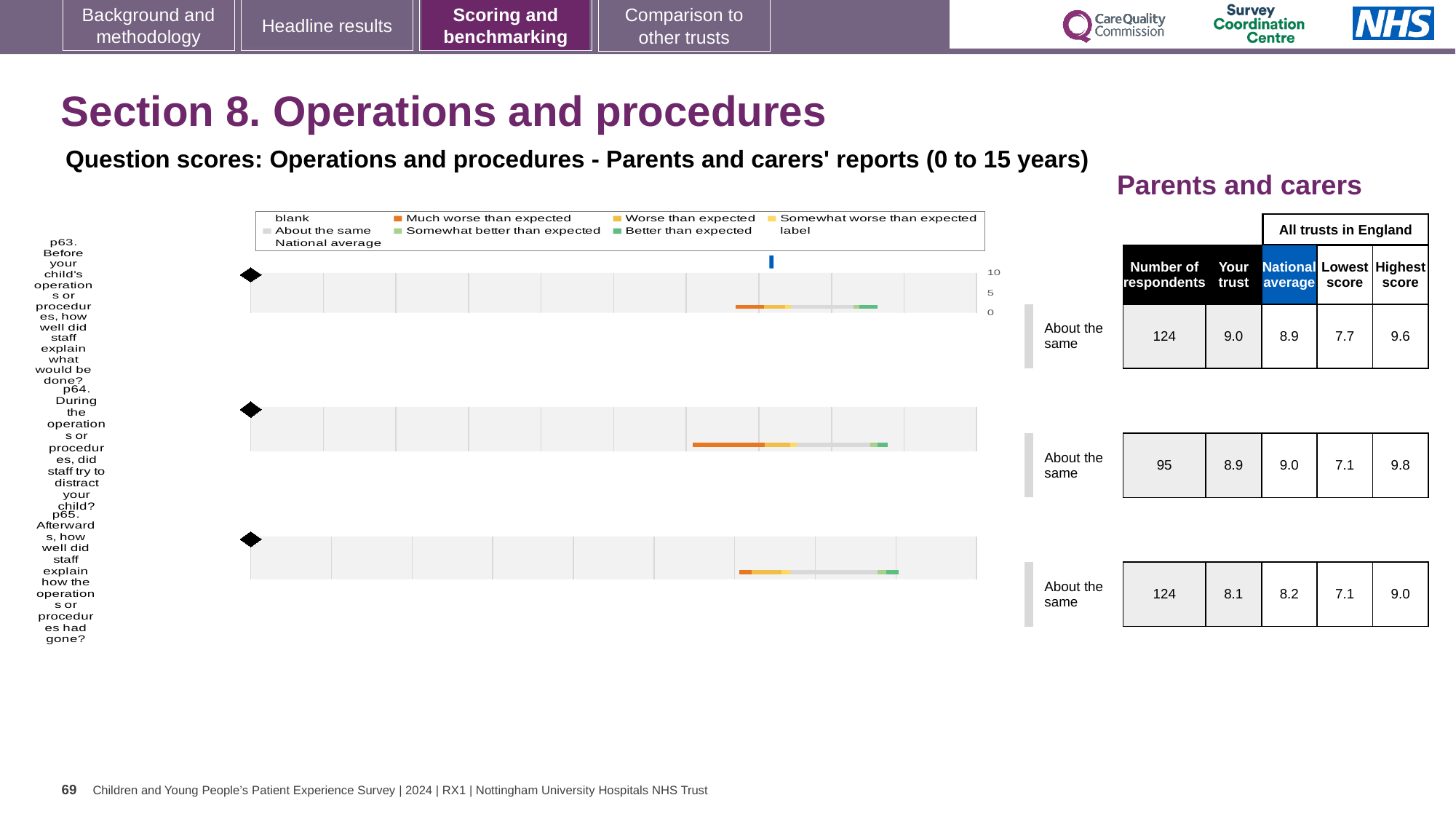
Which of the three questions (p63, p64, p65) has the highest 'Your trust' score? p63 For p63, what is the difference between the highest score (9.6) and the lowest score (7.7) across all trusts in England? 1.9 For p65 (Afterwards, how well did staff explain how the operations or procedures had gone?), how many respondents were there? 124 For p64, what is the highest score among all trusts in England? 9.8 Which of the three questions (p63, p64, p65) has the lowest 'Your trust' score? p65 What colour does the legend use for 'Better than expected'? Green For p64 (During the operations or procedures, did staff try to distract your child?), what is the national average score? 9.0 How many question charts (p63, p64, p65) are shown on the slide? 3 For p65, is the 'Your trust' score (8.1) larger or smaller than the national average (8.2)? Smaller What colour does the legend use for 'Much worse than expected'? Orange For p63 (Before your child's operations or procedures, how well did staff explain what would be done?), what is the 'Your trust' score? 9.0 What benchmark category is shown for p64 (During the operations or procedures, did staff try to distract your child?)? About the same